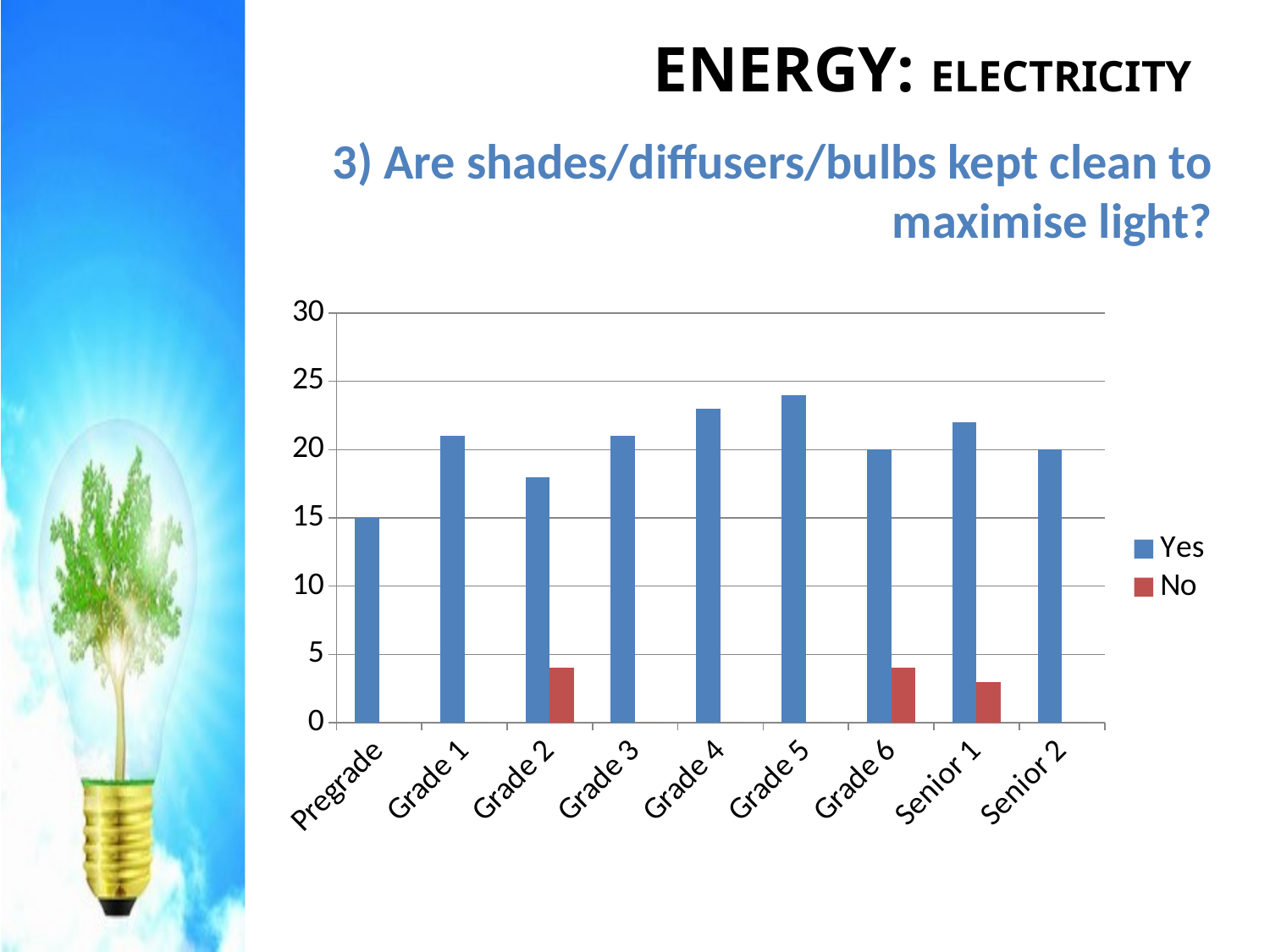
Is the 'Yes' value for Grade 5 greater or less than 20? greater How many series does the legend list? 2 What is the 'Yes' value for Pregrade? 15 Which category has the lowest 'Yes' value? Pregrade Which is larger, the 'Yes' value for Grade 4 or the 'Yes' value for Grade 2? Grade 4 How many categories are shown on the x axis? 9 Is the 'Yes' value for Senior 1 greater or less than 20? greater What are the two series named in the legend? Yes and No Is the 'Yes' value for Grade 2 greater or less than 20? less What colour are the 'No' bars? Red What type of chart is shown on the slide? Bar chart